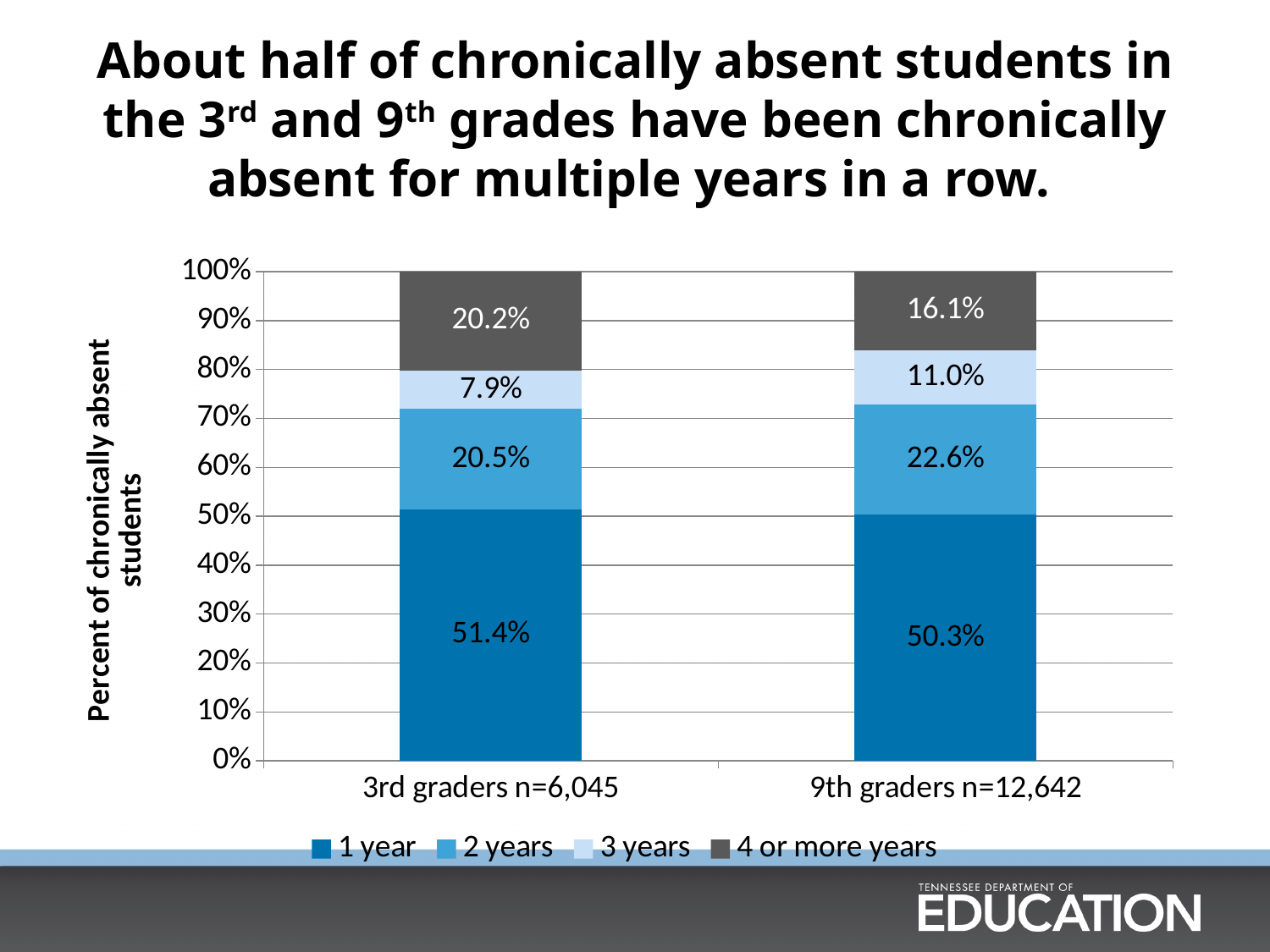
What is the difference between the 4 or more years share for 3rd graders and for 9th graders? 4.1 percentage points What is the value for 3 years among 9th graders? 11.0% Which series has the largest share for 3rd graders? 1 year How many series does the legend list? 4 What percent of chronically absent 3rd graders have been chronically absent for 1 year? 51.4% What kind of chart is shown on the slide? Stacked bar chart What is the sample size (n) for the 9th graders category? 12,642 Which series has the smallest share for 3rd graders? 3 years What is the value for 2 years among 3rd graders? 20.5% How many categories are shown on the x axis? 2 What percent of chronically absent 9th graders have been chronically absent for 4 or more years? 16.1% Which group has a larger share for 2 years, 3rd graders or 9th graders? 9th graders